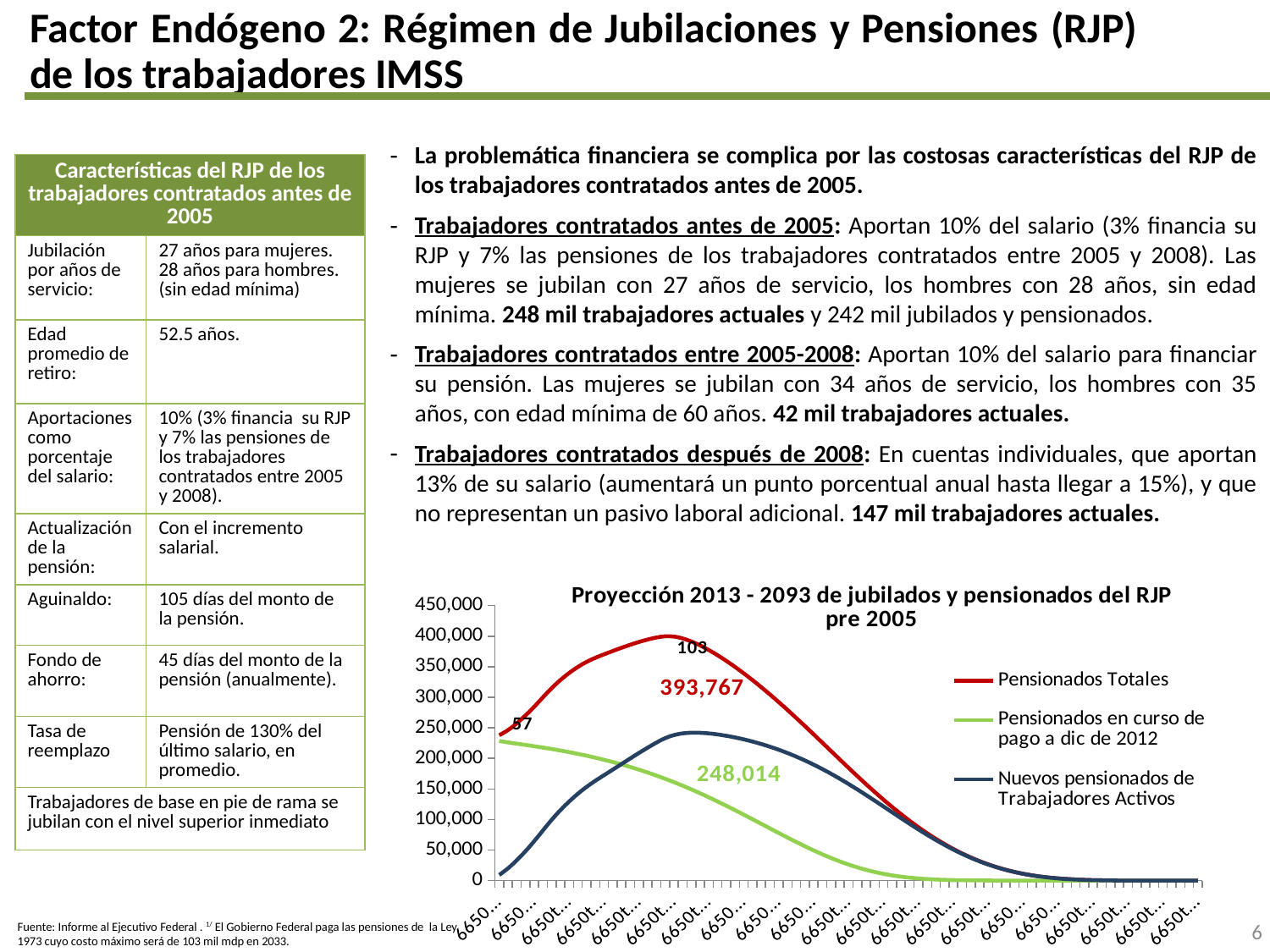
Is the peak value of Nuevos pensionados de Trabajadores Activos greater or less than 200,000? greater Is the starting value of Nuevos pensionados de Trabajadores Activos greater or less than 50,000? less What kind of chart is shown on the slide? line chart What colour is the Pensionados Totales line? red How many series does the chart legend list? 3 What is the title of the chart? Proyección 2013 - 2093 de jubilados y pensionados del RJP pre 2005 Which series reaches the highest peak value in the chart? Pensionados Totales Does the Pensionados en curso de pago a dic de 2012 line rise or fall along the x axis? fall Which series has the lowest value at the left end of the chart? Nuevos pensionados de Trabajadores Activos What value is labelled on the Pensionados en curso de pago a dic de 2012 line? 248,014 What is the peak value labelled on the Pensionados Totales line? 393,767 What is the difference between the two labelled values 393,767 and 248,014? 145,753